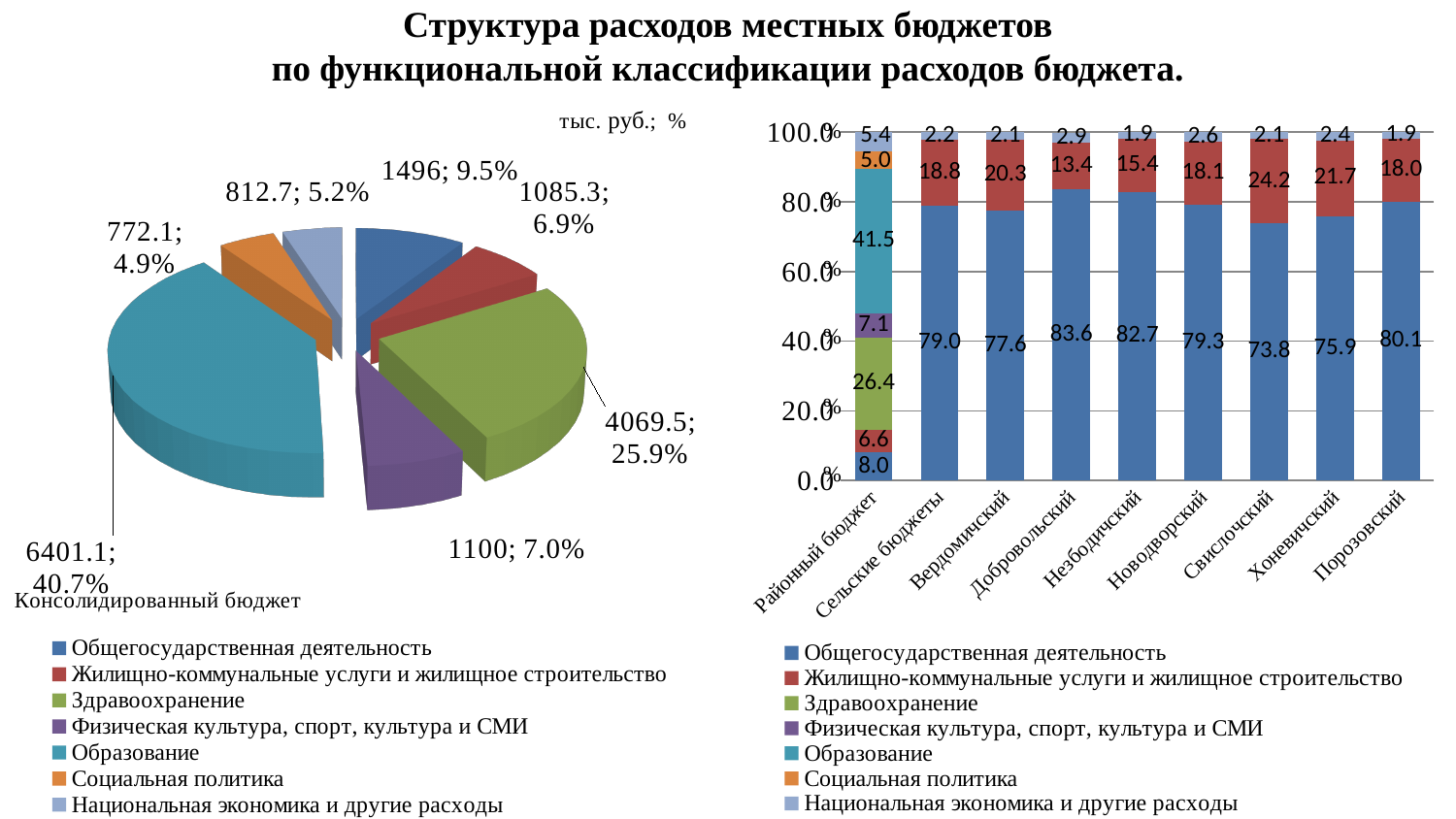
On the stacked bar chart (right), how many series does the legend list? 7 On the stacked bar chart (right), which category has the highest value for Общегосударственная деятельность? Добровольский On the stacked bar chart (right), which is larger: the Жилищно-коммунальные услуги value for Сельские бюджеты or for Незбодичский? Сельские бюджеты On the stacked bar chart (right), what is the value of Жилищно-коммунальные услуги и жилищное строительство for Свислочский? 24.2 On the stacked bar chart (right), what is the value of Образование for Районный бюджет? 41.5 On the pie chart (left), how many slices are there? 7 On the stacked bar chart (right), what is the difference between the Общегосударственная деятельность values for Порозовский and Свислочский? 6.3 On the pie chart (left), what is the share of the Образование slice? 40.7% On the pie chart (left), what value in тыс. руб. is shown for the Здравоохранение slice? 4069.5 On the stacked bar chart (right), what is the value of Общегосударственная деятельность for Добровольский? 83.6 On the pie chart (left), which category has the smallest share? Социальная политика On the stacked bar chart (right), how many categories are shown on the x axis? 9